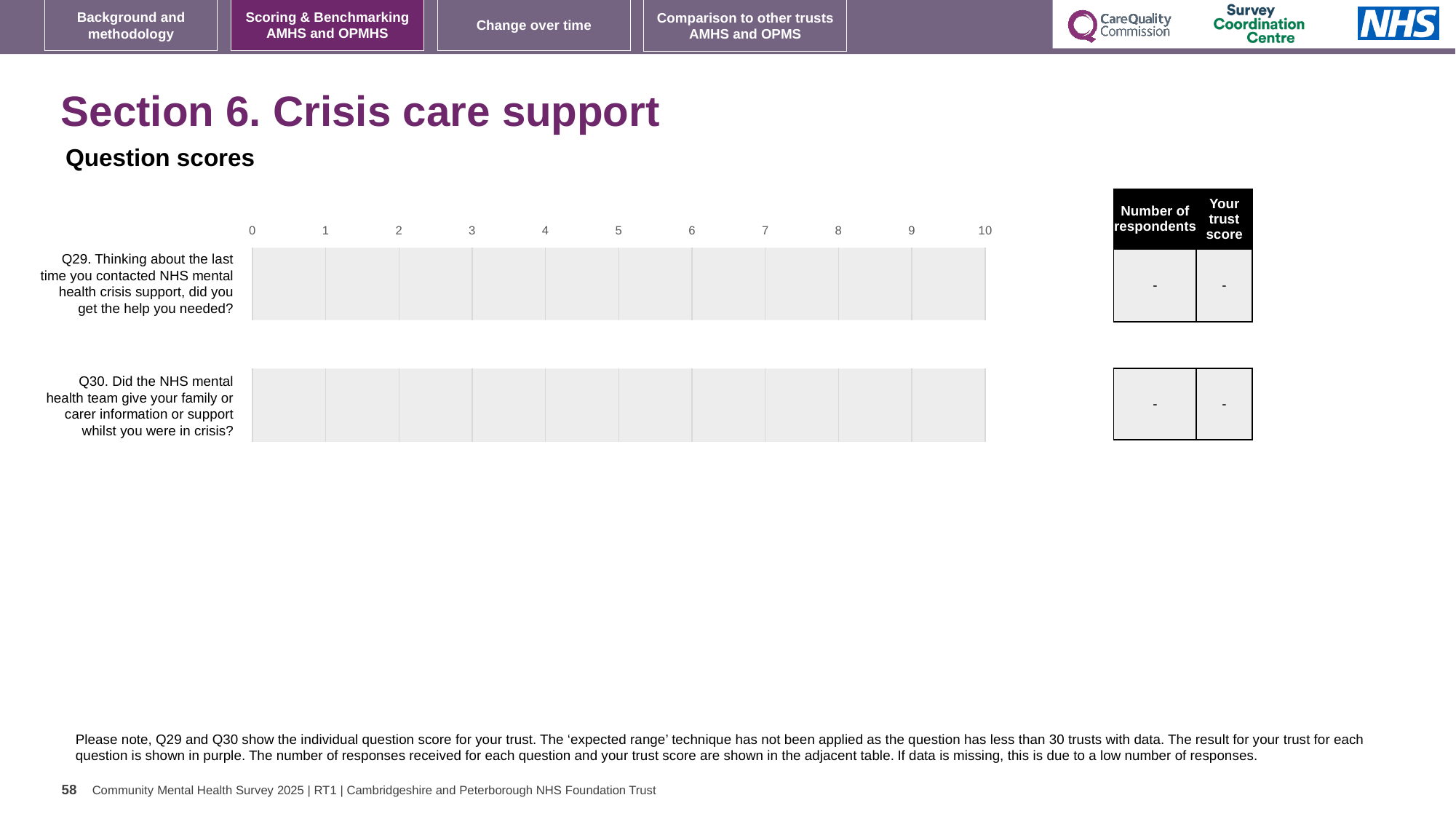
What is the number of respondents shown in the table for Q29? - What is the lowest value shown on the chart's x axis? 0 How many questions (categories) are listed on the chart? 2 What is the highest value shown on the chart's x axis? 10 Which question number is listed first on the chart? Q29 What is the trust score shown in the table for Q30? - What kind of chart is shown on the slide? bar chart